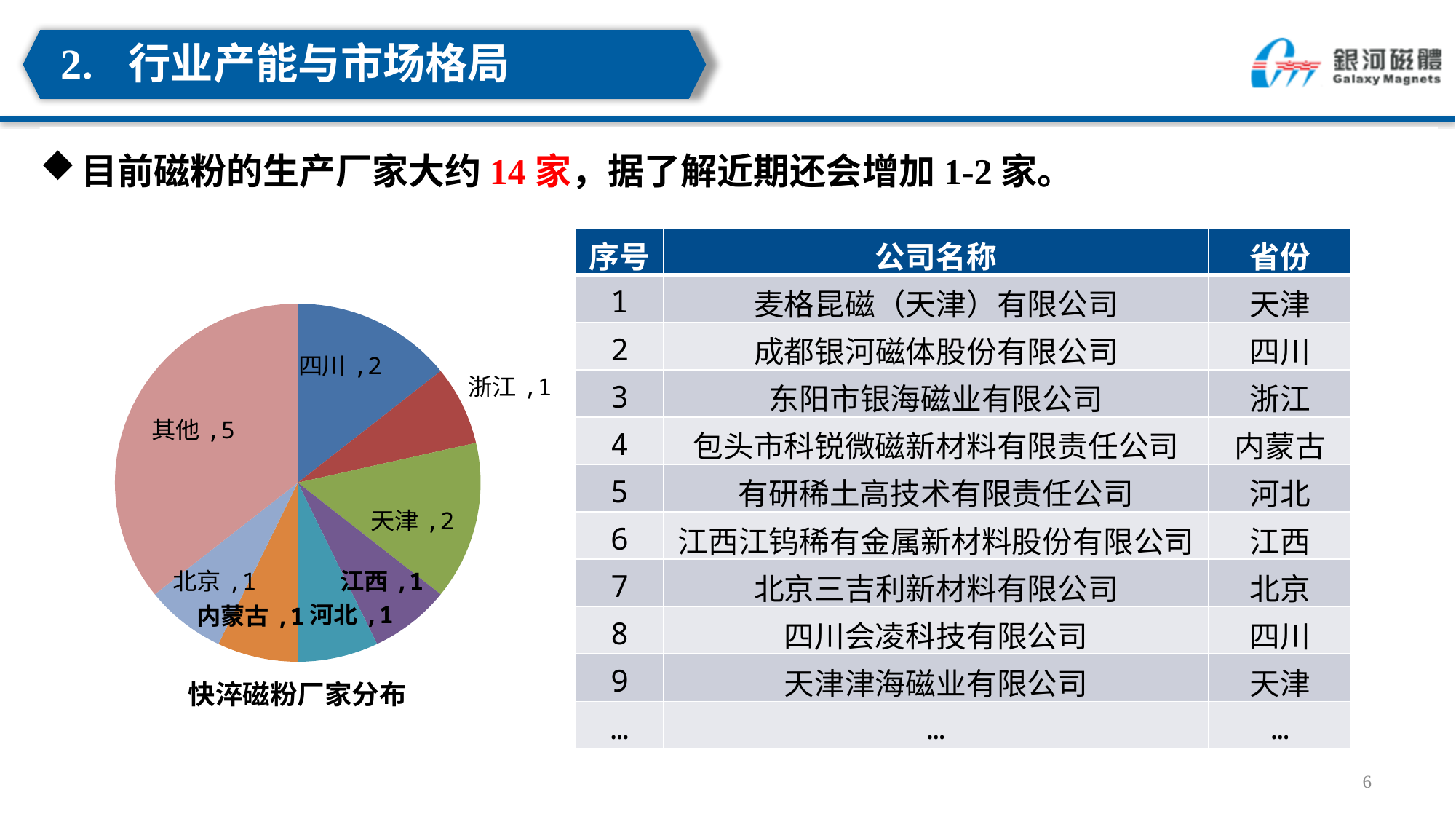
Which is larger in the pie chart, 四川 or 北京? 四川 What is the difference between the values for 其他 and 天津 in the pie chart? 3 What type of chart is shown on the slide? pie chart What is the sum of all the values shown in the pie chart? 14 How many categories in the pie chart have a value of 1? 5 What is the title of the pie chart? 快淬磁粉厂家分布 What is the value for 四川 in the pie chart? 2 What is the value for 浙江 in the pie chart? 1 How many slices does the pie chart have? 8 What is the value for 天津 in the pie chart? 2 Which category has the largest slice in the pie chart? 其他 What is the value for 其他 in the pie chart? 5